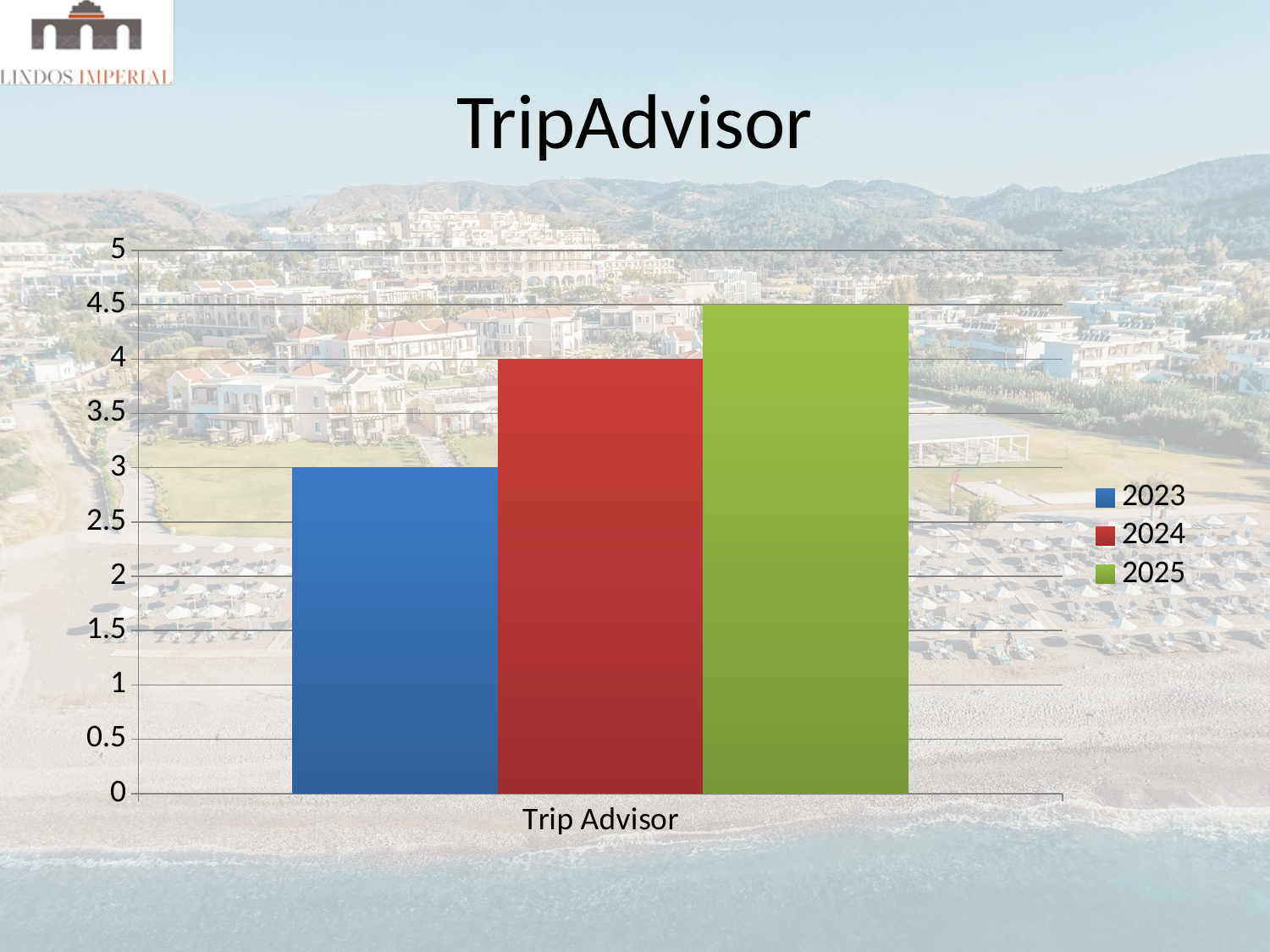
Do the values rise or fall from 2023 to 2025? rise How many series does the legend list? 3 What is the value for 2024 in the Trip Advisor chart? 4 Which year has the highest value? 2025 Which year has the lowest value? 2023 What kind of chart is shown on the slide? bar chart What is the value for 2025 in the Trip Advisor chart? 4.5 What is the difference between the values for 2025 and 2023? 1.5 What is the value for 2023 in the Trip Advisor chart? 3 Which is larger, the value for 2024 or the value for 2025? 2025 Is the value for 2023 greater or less than 3.5? less What is the difference between the values for 2024 and 2023? 1